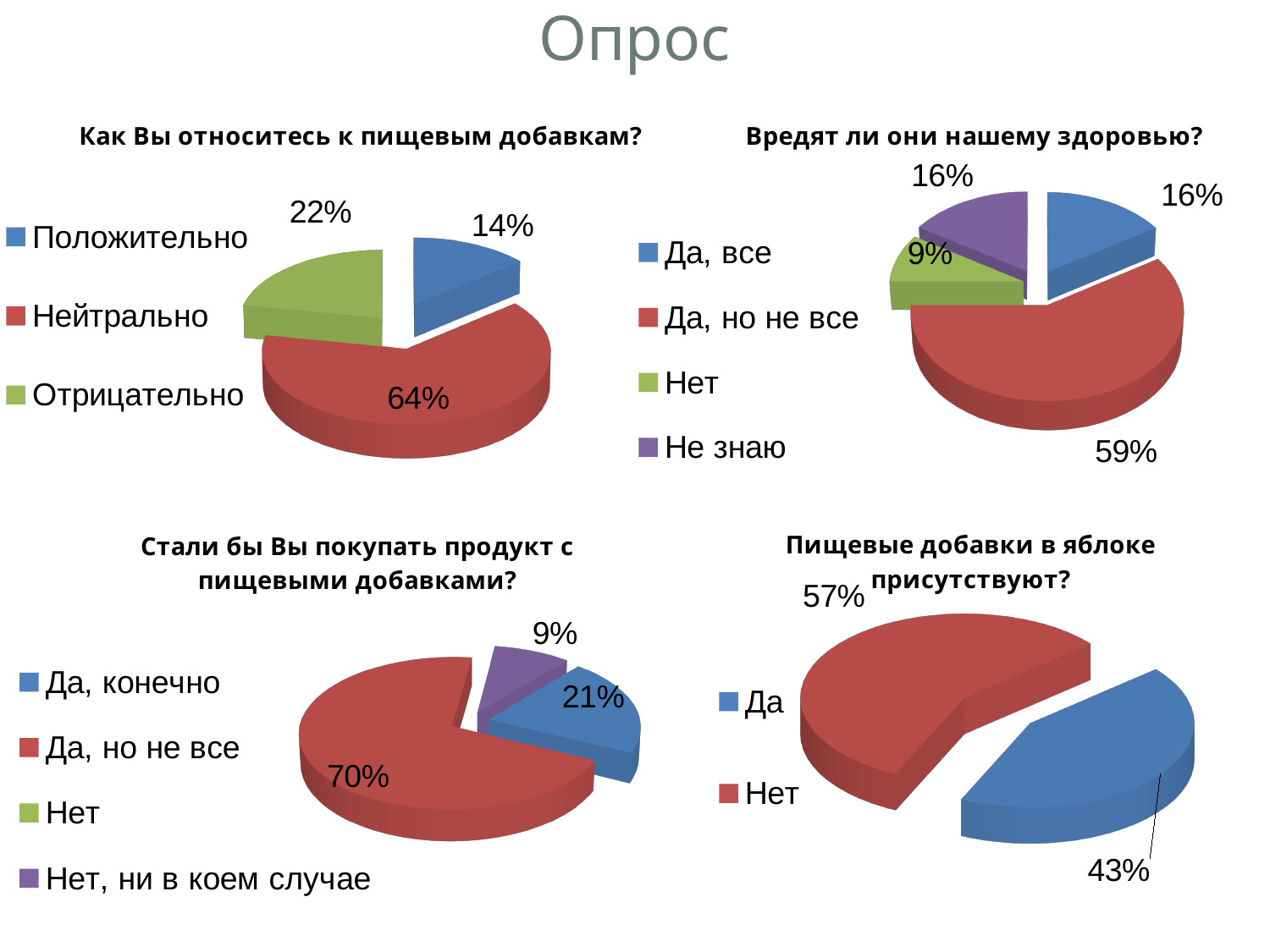
In the chart titled "Вредят ли они нашему здоровью?", which answer has the largest share? Да, но не все In the chart titled "Стали бы Вы покупать продукт с пищевыми добавками?", what share of respondents answered "Да, конечно"? 21% How many charts are shown on the slide? 4 In the chart titled "Пищевые добавки в яблоке присутствуют?", what share of respondents answered "Да"? 43% In the chart titled "Как Вы относитесь к пищевым добавкам?", which answer has the smallest share? Положительно What type of chart is used for the four charts on this slide? Pie chart In the chart titled "Пищевые добавки в яблоке присутствуют?", what is the difference between the shares for "Нет" and "Да"? 14% In the chart titled "Как Вы относитесь к пищевым добавкам?", what share of respondents answered "Нейтрально"? 64% In the chart titled "Стали бы Вы покупать продукт с пищевыми добавками?", which is larger: the share for "Да, конечно" or for "Нет, ни в коем случае"? Да, конечно In the chart titled "Вредят ли они нашему здоровью?", how many entries does the legend list? 4 In the chart titled "Как Вы относитесь к пищевым добавкам?", what is the difference between the shares for "Отрицательно" and "Положительно"? 8% In the chart titled "Вредят ли они нашему здоровью?", what share of respondents answered "Нет"? 9%